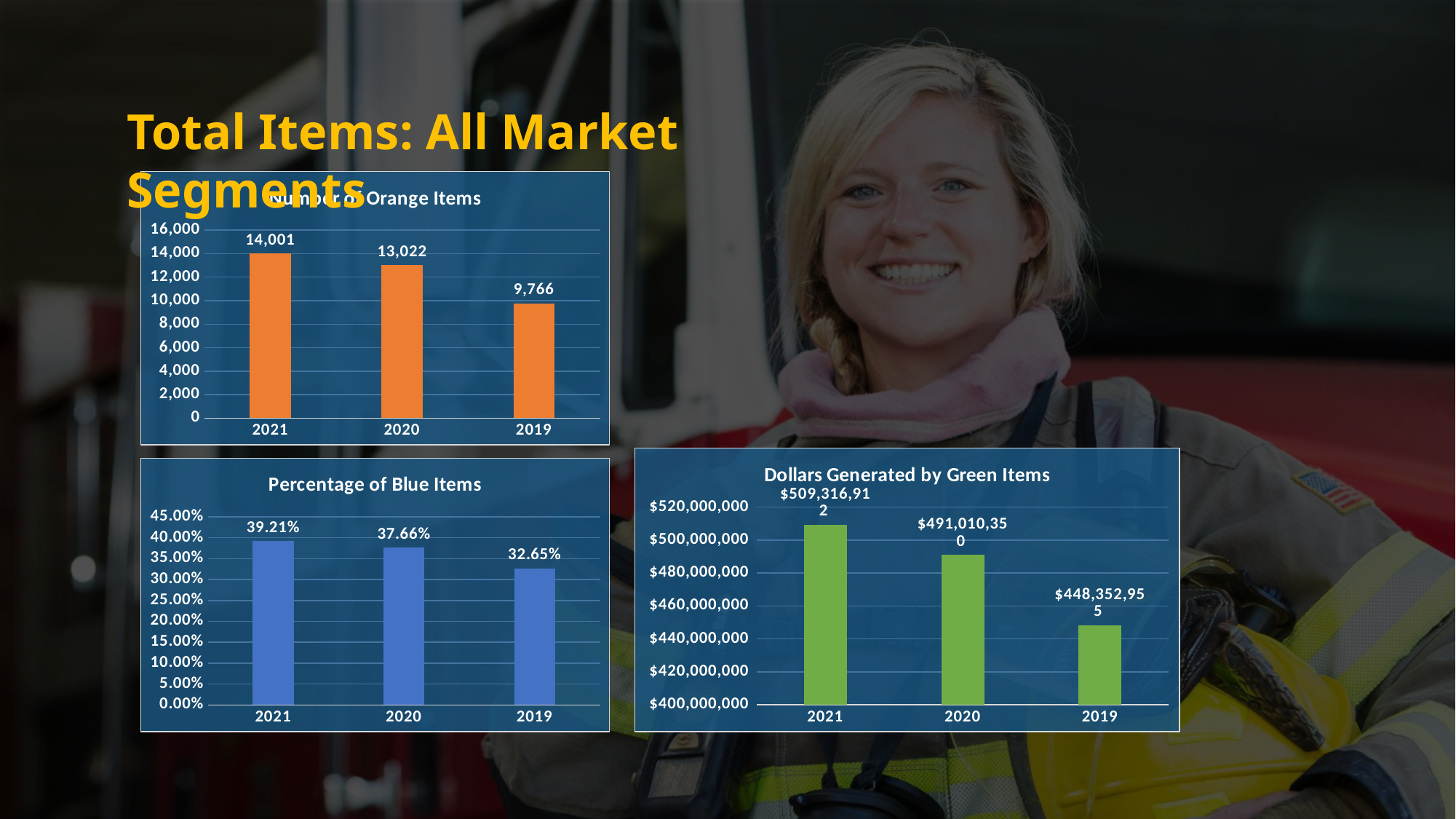
In the 'Percentage of Blue Items' chart, what is the value for 2020? 37.66% In the 'Number of Orange Items' chart, what is the value for 2021? 14,001 How many bars are plotted in the 'Dollars Generated by Green Items' chart? 3 In the 'Dollars Generated by Green Items' chart, what is the value for 2019? $448,352,955 In the 'Number of Orange Items' chart, what is the difference between the 2021 and 2020 values? 979 In the 'Number of Orange Items' chart, what is the value for 2019? 9,766 In the 'Dollars Generated by Green Items' chart, which is larger, the value for 2020 or the value for 2019? 2020 In the 'Percentage of Blue Items' chart, which year has the highest value? 2021 What type of chart is the 'Percentage of Blue Items' chart? Bar chart In the 'Number of Orange Items' chart, which year has the lowest value? 2019 In the 'Percentage of Blue Items' chart, is the value for 2019 greater or less than 35.00%? less In the 'Dollars Generated by Green Items' chart, what is the value for 2021? $509,316,912